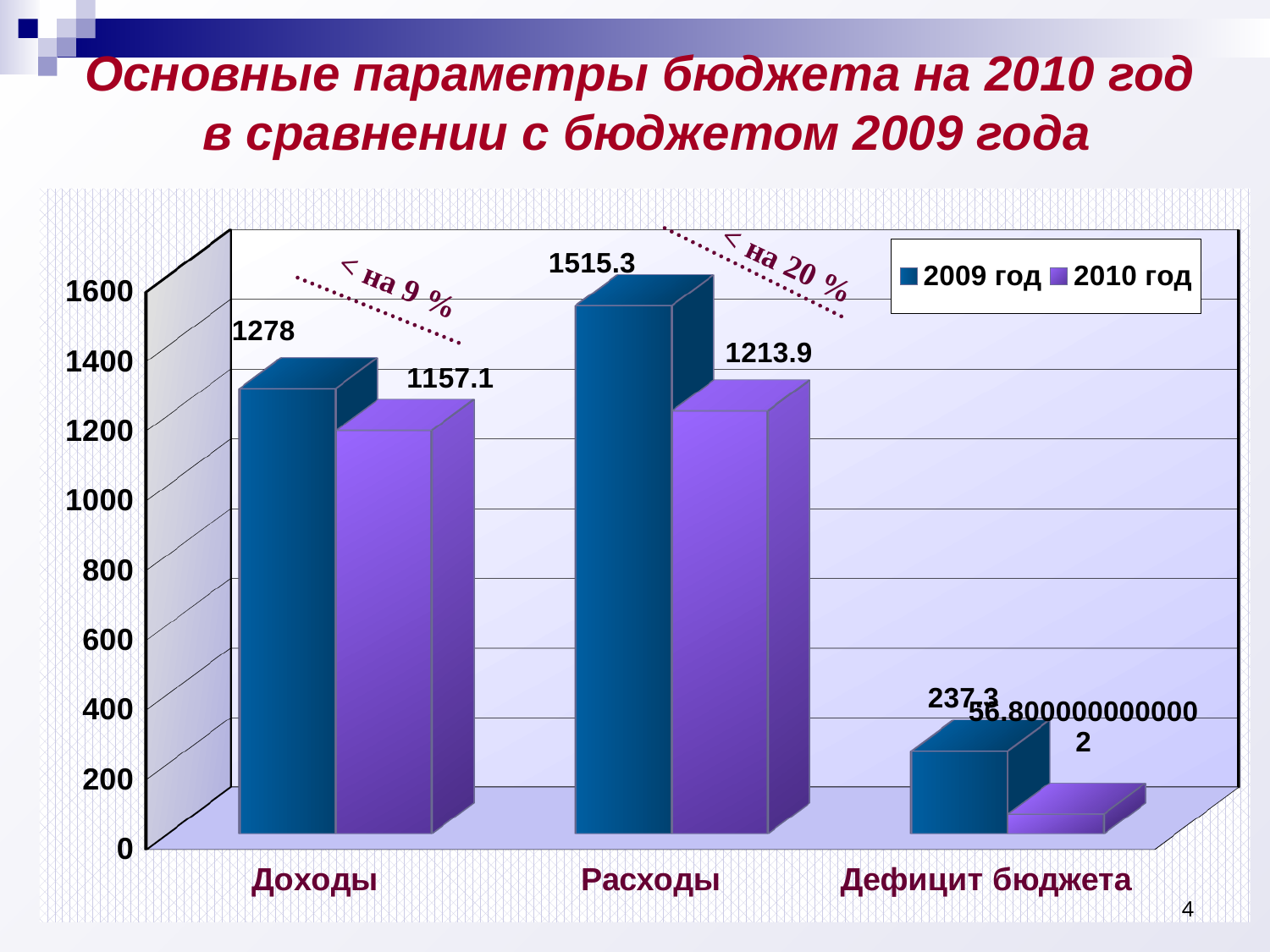
What is the value for Доходы in 2010 год? 1157.1 How many series does the legend list? 2 What is the value for Доходы in 2009 год? 1278 Which category has the highest value in the 2009 год series? Расходы Which category has the lowest value in the 2010 год series? Дефицит бюджета Which is larger: Доходы in 2009 год or Доходы in 2010 год? Доходы in 2009 год What kind of chart is shown on the slide? bar chart What is the difference between the 2009 год and 2010 год values for Расходы? 301.4 What is the value for Расходы in 2009 год? 1515.3 Is the value for Дефицит бюджета in 2010 год greater or less than 200? less What is the value for Дефицит бюджета in 2009 год? 237.3 What is the value for Расходы in 2010 год? 1213.9